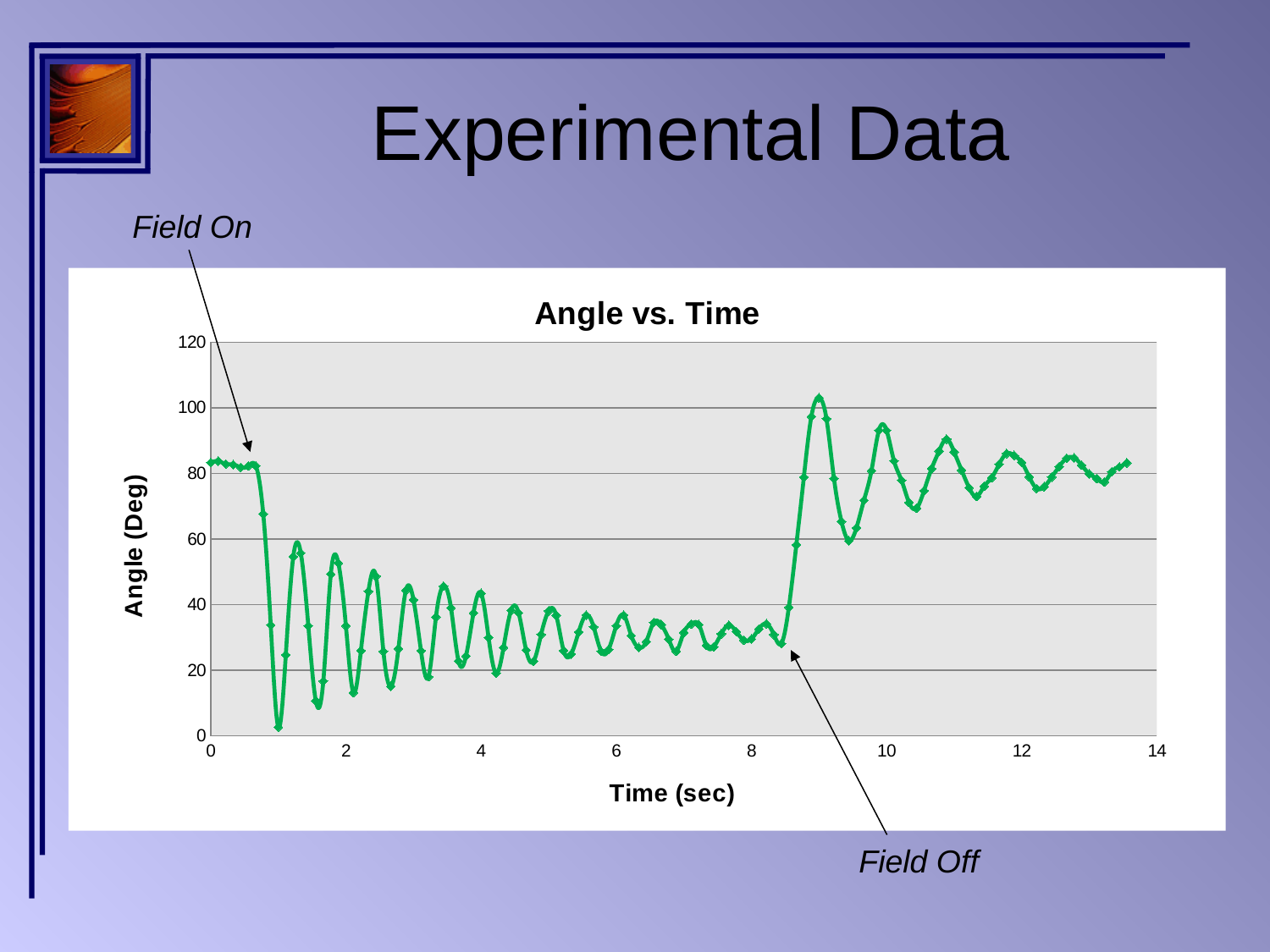
Between about 1 second and 8 seconds, does the amplitude of the oscillation increase or decrease over time? decrease Is the angle value at about 13.5 seconds greater or less than 60? greater What is the title of the chart? Angle vs. Time Is the highest peak after 'Field Off' (near 9 sec) greater or less than 80? greater Is the angle value at time 0 greater or less than 60? greater What is the label of the vertical axis of the chart? Angle (Deg) What kind of chart is shown on the slide? line chart Which is larger: the angle at about 8 seconds or the angle at about 10 seconds? the angle at about 10 seconds